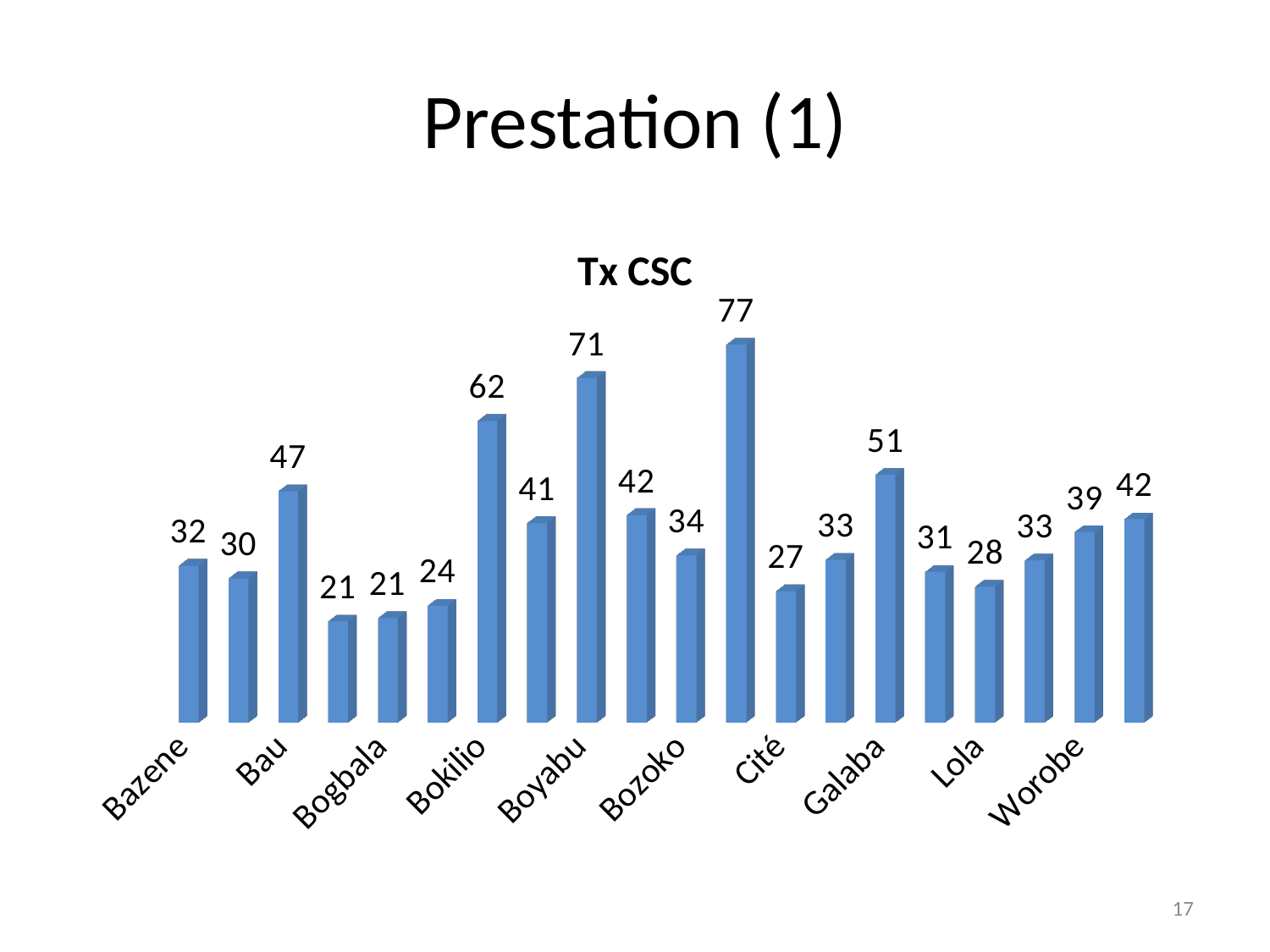
Which has the larger value, Bokilio or Galaba? Bokilio What is the value for Bau? 47 What is the highest value shown in the chart? 77 What is the value for Bokilio? 62 How many bars are plotted in the chart? 20 What is the value for Bazene? 32 What is the lowest value shown in the chart? 21 What is the difference between the values for Boyabu and Bazene? 39 What is the value for Galaba? 51 What kind of chart is shown on the slide? bar chart What is the title of the chart? Tx CSC What is the value for Boyabu? 71